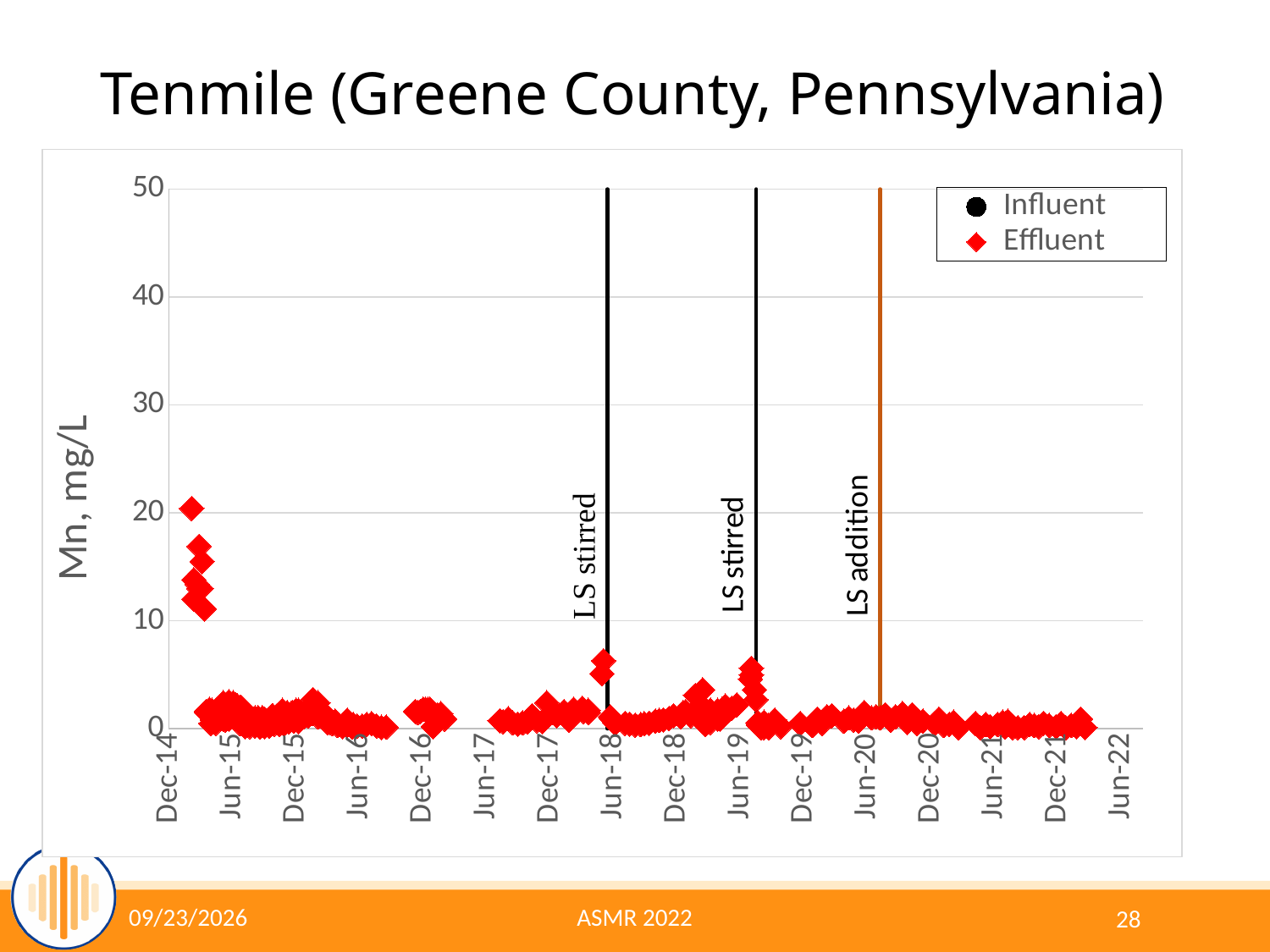
Around which x-axis date do the highest Effluent values occur? Dec-14 Which series is plotted with red diamond markers? Effluent Is the highest Effluent value near Jun-19 greater or less than 10 mg/L? less Overall, do the Effluent values rise or fall from Dec-14 to Dec-21? fall Is the highest Effluent value, near Dec-14, greater or less than 10 mg/L? greater What is the title of the chart? Tenmile (Greene County, Pennsylvania) What is the label of the vertical line drawn just after Jun-20? LS addition Are the Effluent values after Jun-20 greater or less than 10 mg/L? less How many vertical event lines are drawn on the chart? 3 What kind of chart is shown on the slide? scatter chart How many series does the legend list? 2